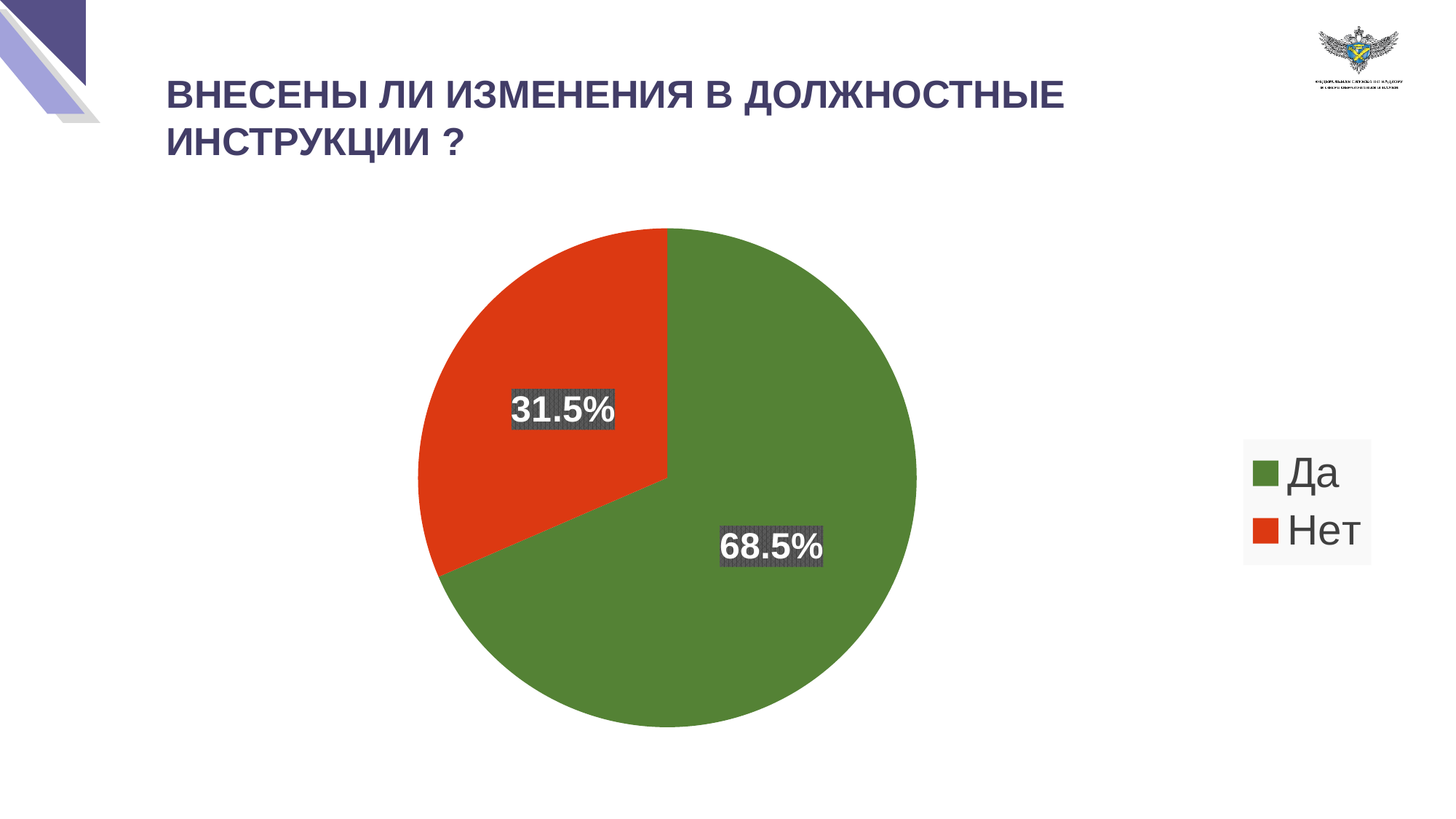
How many slices does the pie chart have? 2 What is the value for "Нет"? 31.5% How many entries does the legend list? 2 What is the difference between the "Да" and "Нет" slices? 37% What is the value for "Да"? 68.5% What colour is the "Нет" slice? red What kind of chart is shown on the slide? pie chart Which slice is the smallest? Нет Which slice is the largest? Да Which is larger, "Да" or "Нет"? Да What share of the pie does the "Нет" slice take? 31.5% What colour is the "Да" slice? green